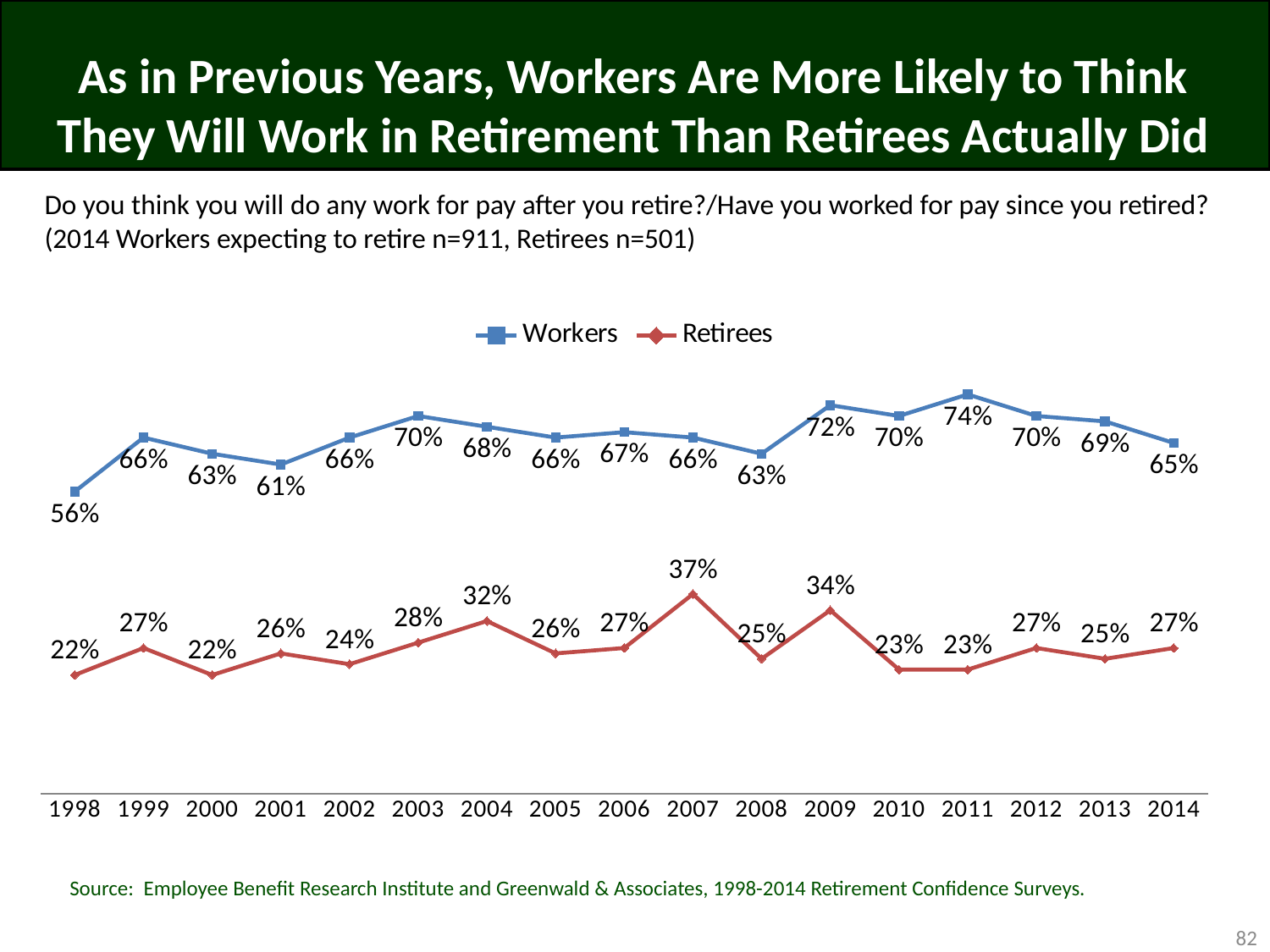
Which series had the higher value in 2009, Workers or Retirees? Workers In which year did the Workers series reach its highest value? 2011 What colour is the Retirees line? Red How many series does the legend list? 2 What percentage of Retirees reported having worked for pay since retiring in 2007? 37% What is the difference between the Workers value and the Retirees value in 2014? 38 percentage points In which year was the Workers series at its lowest value? 1998 What percentage of Workers expected to work for pay after retiring in 2014? 65% Did the Workers series rise or fall from 2011 to 2014? Fall How many years are shown on the x axis? 17 What kind of chart is shown on the slide? Line chart In which year did the Retirees series reach its highest value? 2007